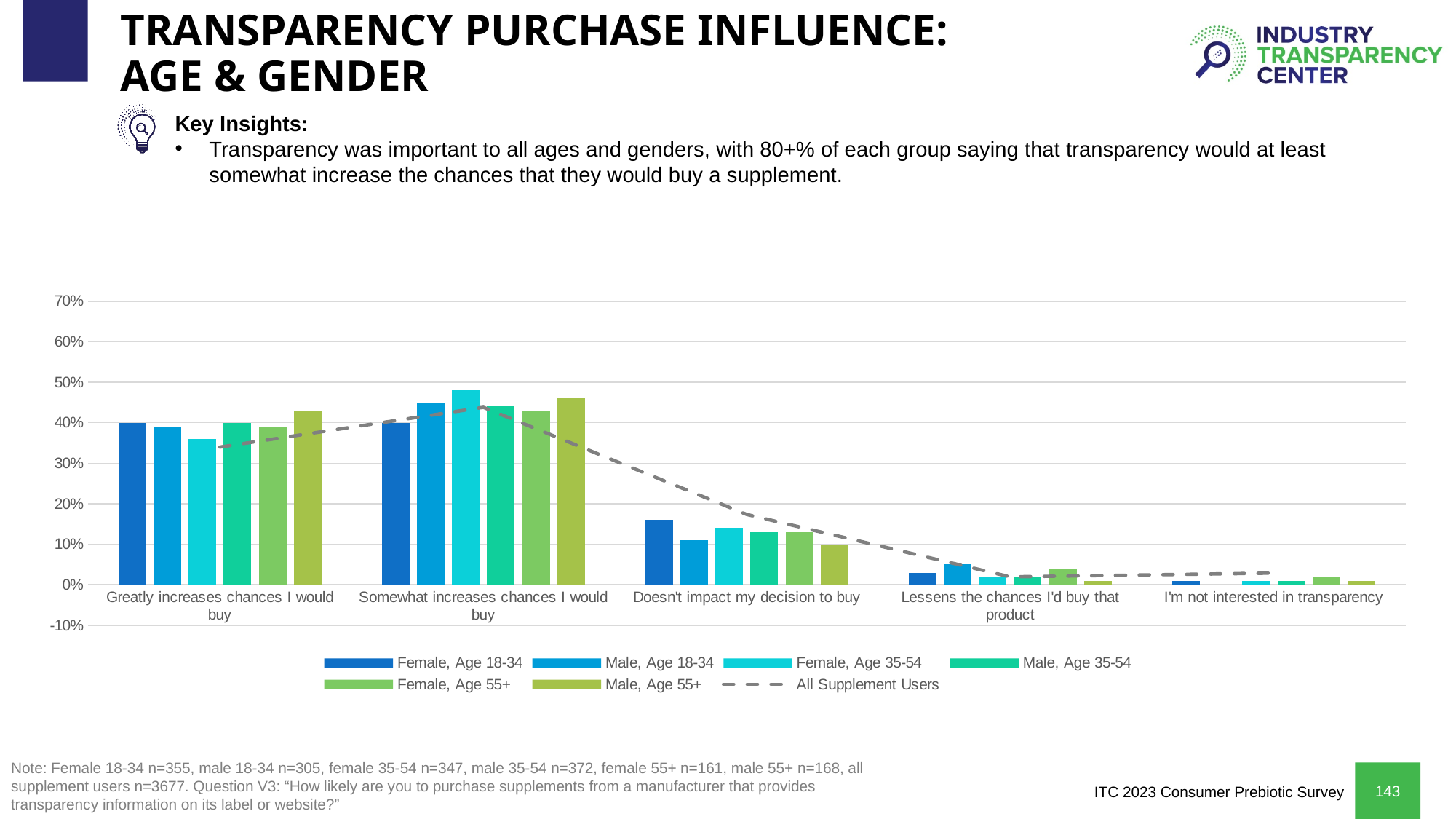
Which group has the highest bar in 'Doesn't impact my decision to buy'? Female, Age 18-34 For Female, Age 35-54, which is larger: the bar for 'Greatly increases chances I would buy' or the bar for 'Somewhat increases chances I would buy'? Somewhat increases chances I would buy How many entries does the chart's legend list? 7 Which group has the lowest bar in 'Greatly increases chances I would buy'? Female, Age 35-54 Is the value for Female, Age 35-54 in 'Somewhat increases chances I would buy' greater or less than 50%? less Is the value for Female, Age 35-54 in 'Greatly increases chances I would buy' greater or less than 40%? less Is the value for Female, Age 18-34 in 'Doesn't impact my decision to buy' greater or less than 10%? greater Which series is shown as a dashed line rather than bars? All Supplement Users How many response categories are shown along the x axis of the chart? 5 Does the All Supplement Users dashed line rise or fall from 'Somewhat increases chances I would buy' to 'I'm not interested in transparency'? Fall What kind of chart is shown on the slide? Combination bar and line chart